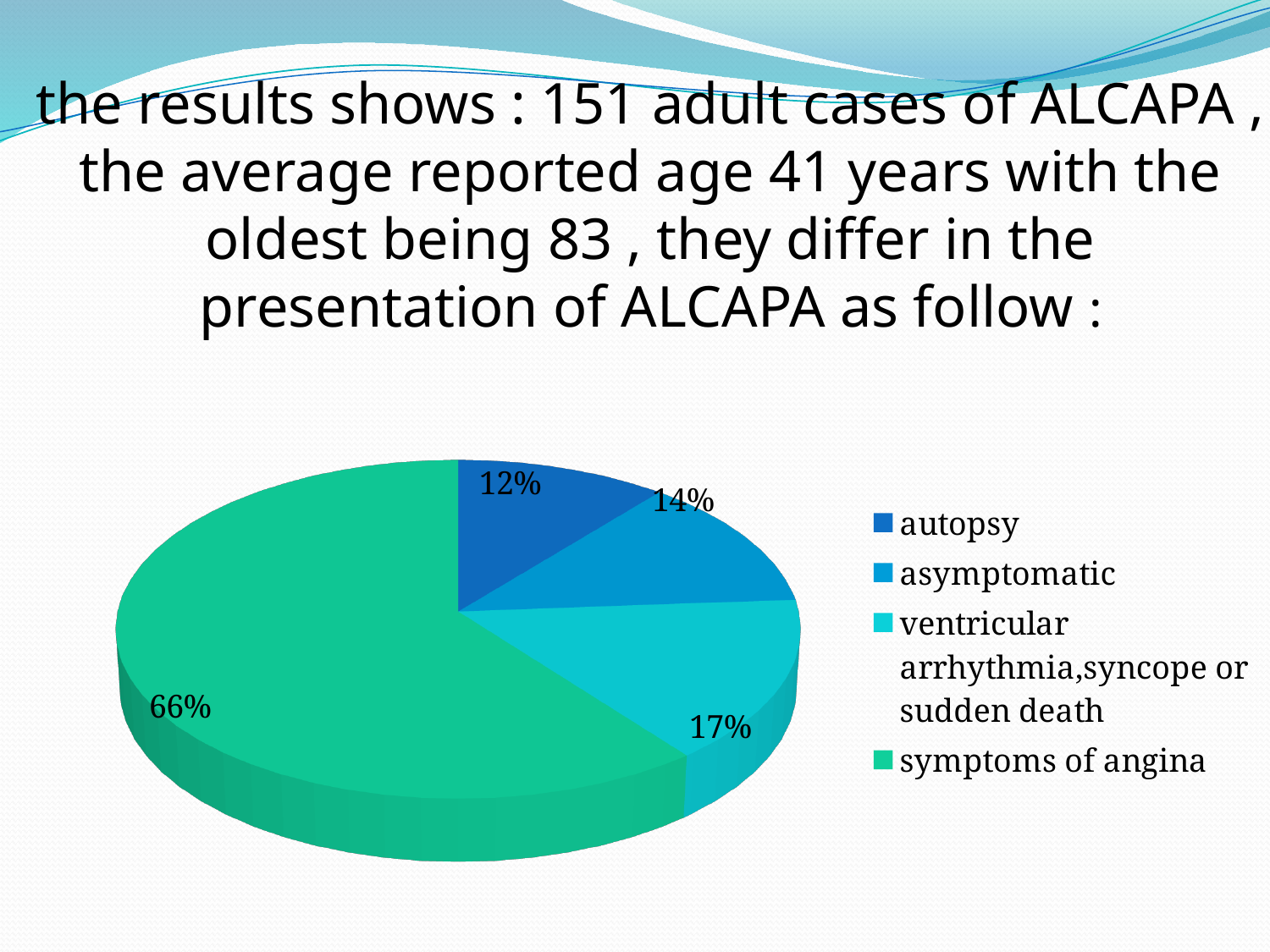
What is the difference in percentage points between asymptomatic and autopsy? 2 What percentage of the pie is labelled for symptoms of angina? 66% Which legend entry is shown in the darkest blue colour? autopsy What percentage of the pie is labelled for ventricular arrhythmia, syncope or sudden death? 17% Which presentation category has the smallest slice of the pie? autopsy How many categories does the pie chart show? 4 What is the difference in percentage points between symptoms of angina and ventricular arrhythmia, syncope or sudden death? 49 Which is larger, the slice for asymptomatic or the slice for autopsy? asymptomatic Which presentation category has the largest slice of the pie? symptoms of angina What kind of chart is shown on the slide? pie chart What percentage of the pie is labelled for asymptomatic? 14% What percentage of the pie is labelled for autopsy? 12%